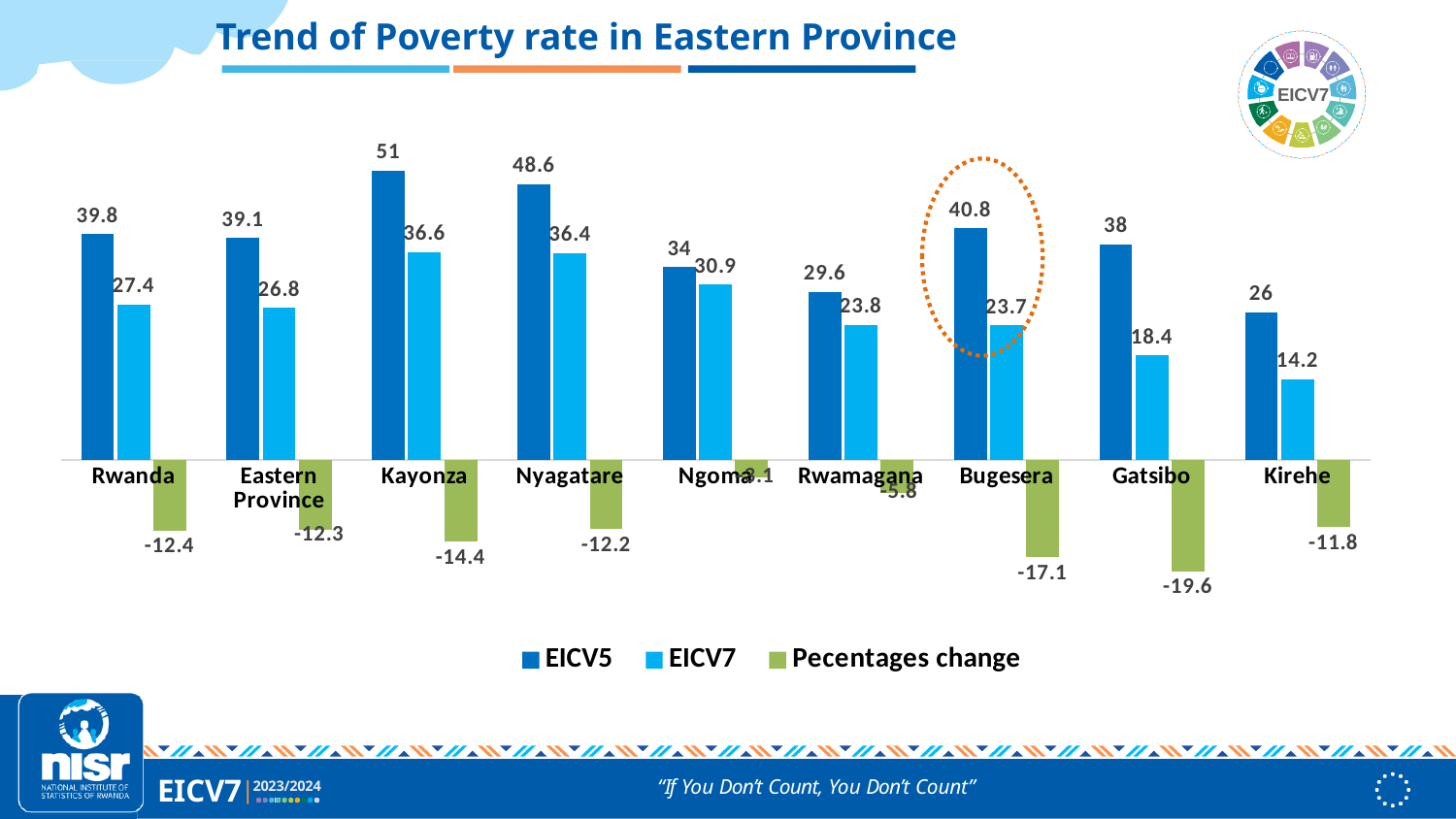
Which category has the lowest EICV7 poverty rate? Kirehe What kind of chart is shown on the slide? Bar chart What is the EICV7 poverty rate for Bugesera? 23.7 Which category is highlighted with a dotted orange circle? Bugesera How many categories are shown on the x axis? 9 What is the EICV5 poverty rate for Kayonza? 51 Which category has the highest EICV5 poverty rate? Kayonza What is the percentage change value shown for Gatsibo? -19.6 Which is larger, the EICV7 poverty rate for Nyagatare or for Ngoma? Nyagatare How many series does the legend list? 3 What is the difference between the EICV5 and EICV7 poverty rates for Rwanda? 12.4 What is the title of the chart? Trend of Poverty rate in Eastern Province